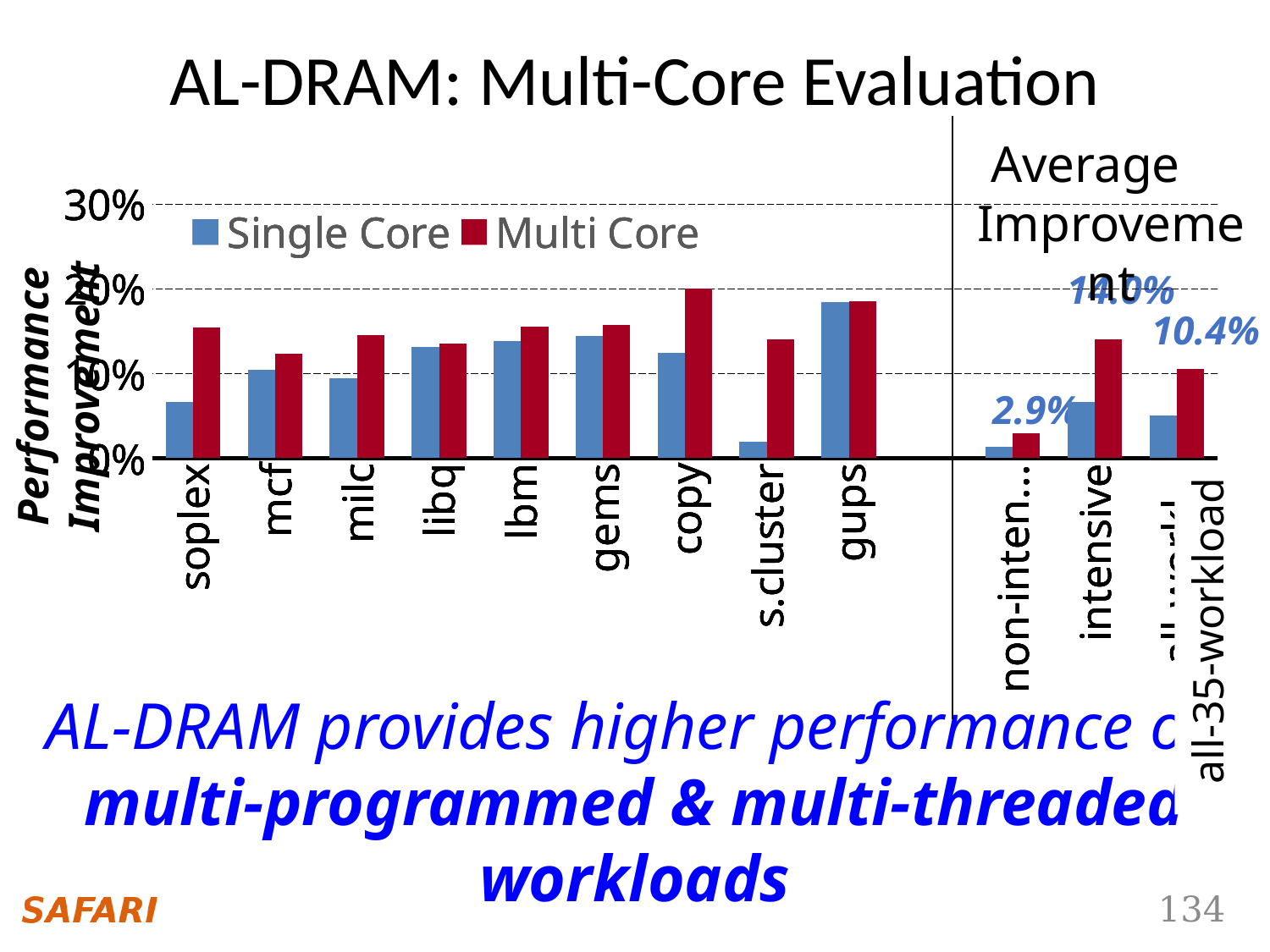
What are the two series named in the legend? Single Core and Multi Core Which benchmark has the highest Single Core bar? gups What value is labeled for the non-intensive category? 2.9% What is the title of the slide's chart? AL-DRAM: Multi-Core Evaluation Is the Single Core value for s.cluster greater or less than 10%? less Is the Single Core value for soplex greater or less than 10%? less What value is labeled for the all-35-workload category? 10.4% Is the Multi Core value for gups greater or less than 10%? greater What kind of chart is shown on the slide? bar chart Among the nine benchmarks left of the divider, which has the lowest Single Core bar? s.cluster How many series does the legend list? 2 For s.cluster, which is larger: the Single Core or the Multi Core value? Multi Core